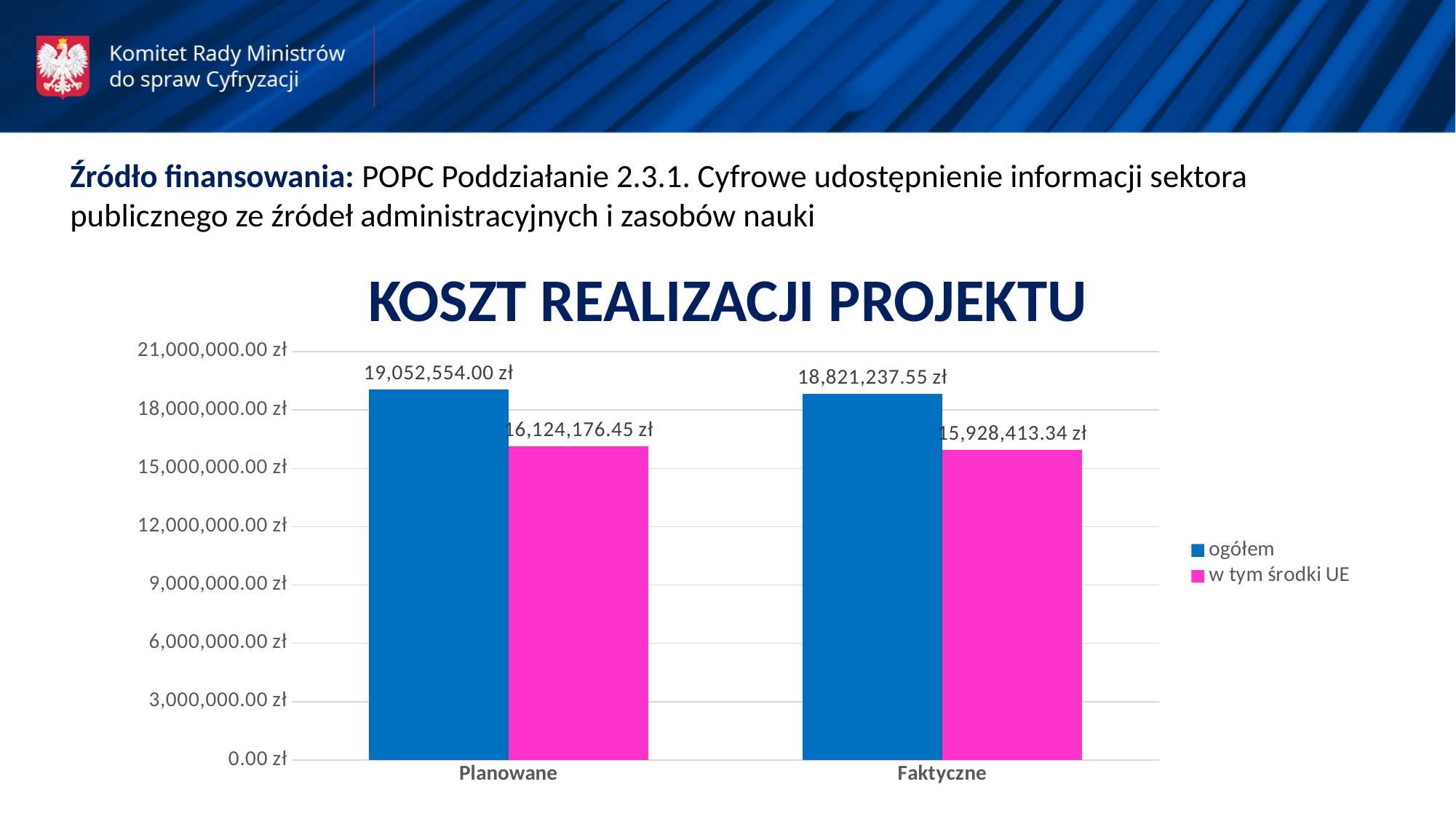
Which series is shown in pink? w tym środki UE How many series does the legend list? 2 What is the value of 'w tym środki UE' for Faktyczne? 15,928,413.34 zł What is the value of 'w tym środki UE' for Planowane? 16,124,176.45 zł What type of chart is shown on the slide? bar chart What is the difference between the 'ogółem' values for Planowane and Faktyczne? 231,316.45 zł What is the difference between 'ogółem' and 'w tym środki UE' for Planowane? 2,928,377.55 zł What is the value of 'ogółem' for Planowane? 19,052,554.00 zł How many categories are shown on the x axis? 2 Which category has the higher 'ogółem' value, Planowane or Faktyczne? Planowane What is the chart's title? KOSZT REALIZACJI PROJEKTU Is the 'w tym środki UE' value for Faktyczne greater or less than 15,000,000.00 zł? greater